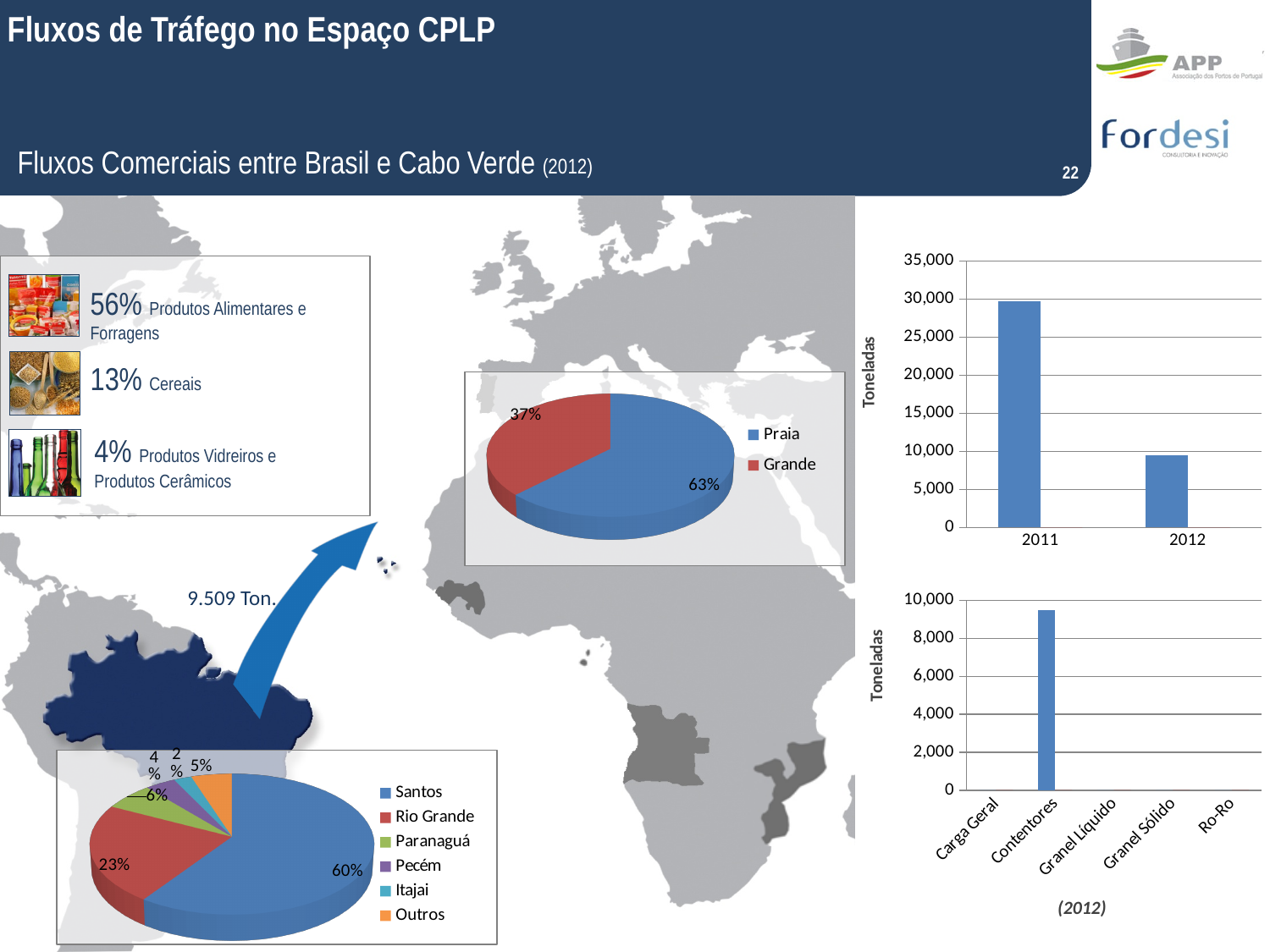
In the pie chart at the bottom left of the slide, which port has the largest share? Santos In the pie chart at the bottom left of the slide, what is the difference in percentage points between Santos and Rio Grande? 37 percentage points In the bar chart at the top right of the slide, do the values rise or fall from 2011 to 2012? fall In the pie chart at the bottom left of the slide, how many entries does the legend list? 6 In the pie chart at the bottom left of the slide, what share does Santos have? 60% In the bar chart at the top right of the slide, is the value for 2011 greater or less than 25,000? greater In the pie chart at the bottom left of the slide, what share does Rio Grande have? 23% In the bar chart at the bottom right of the slide, which category has the highest value? Contentores In the pie chart in the centre of the slide, how many slices are there? 2 In the pie chart in the centre of the slide, what share does Grande have? 37% In the pie chart in the centre of the slide, what share does Praia have? 63% In the bar chart at the bottom right of the slide, how many categories are shown on the x axis? 5